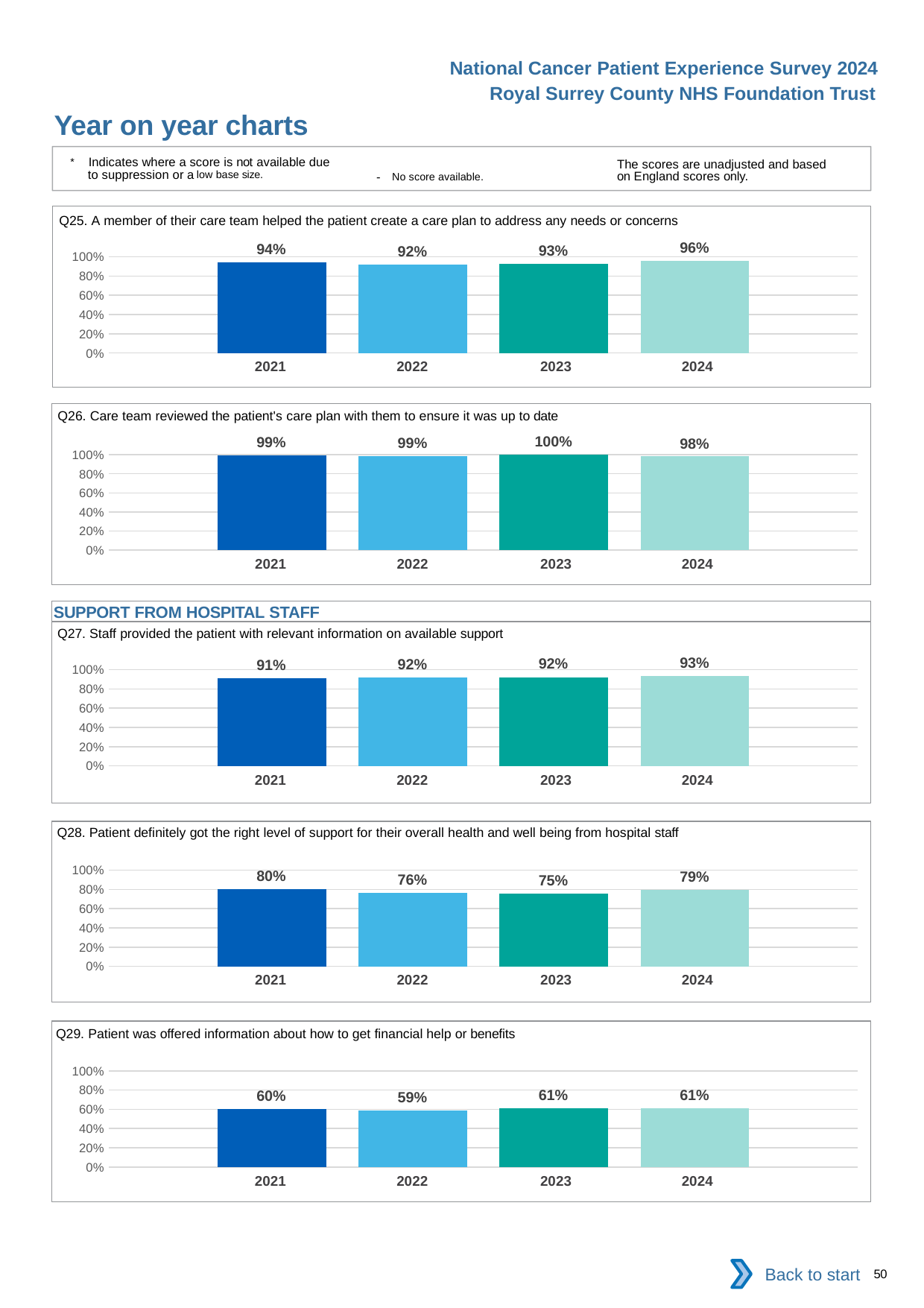
In the Q29 chart, which is larger, the value for 2021 or the value for 2022? 2021 In the Q27 chart, do the values rise or fall from 2021 to 2024? rise In the Q26 chart, what is the value for 2023? 100% In the Q27 chart, what is the value for 2021? 91% In the Q26 chart, what is the difference between the 2023 and 2024 values? 2% In the Q28 chart, is the value for 2022 greater or less than 80%? less What kind of chart is the Q29 chart? bar chart How many years are shown in the Q29 chart? 4 In the Q28 chart, which year has the highest value? 2021 In the Q25 chart, which year has the lowest value? 2022 In the Q25 chart, what is the value for 2024? 96% In the Q28 chart, what is the difference between the 2021 and 2023 values? 5%